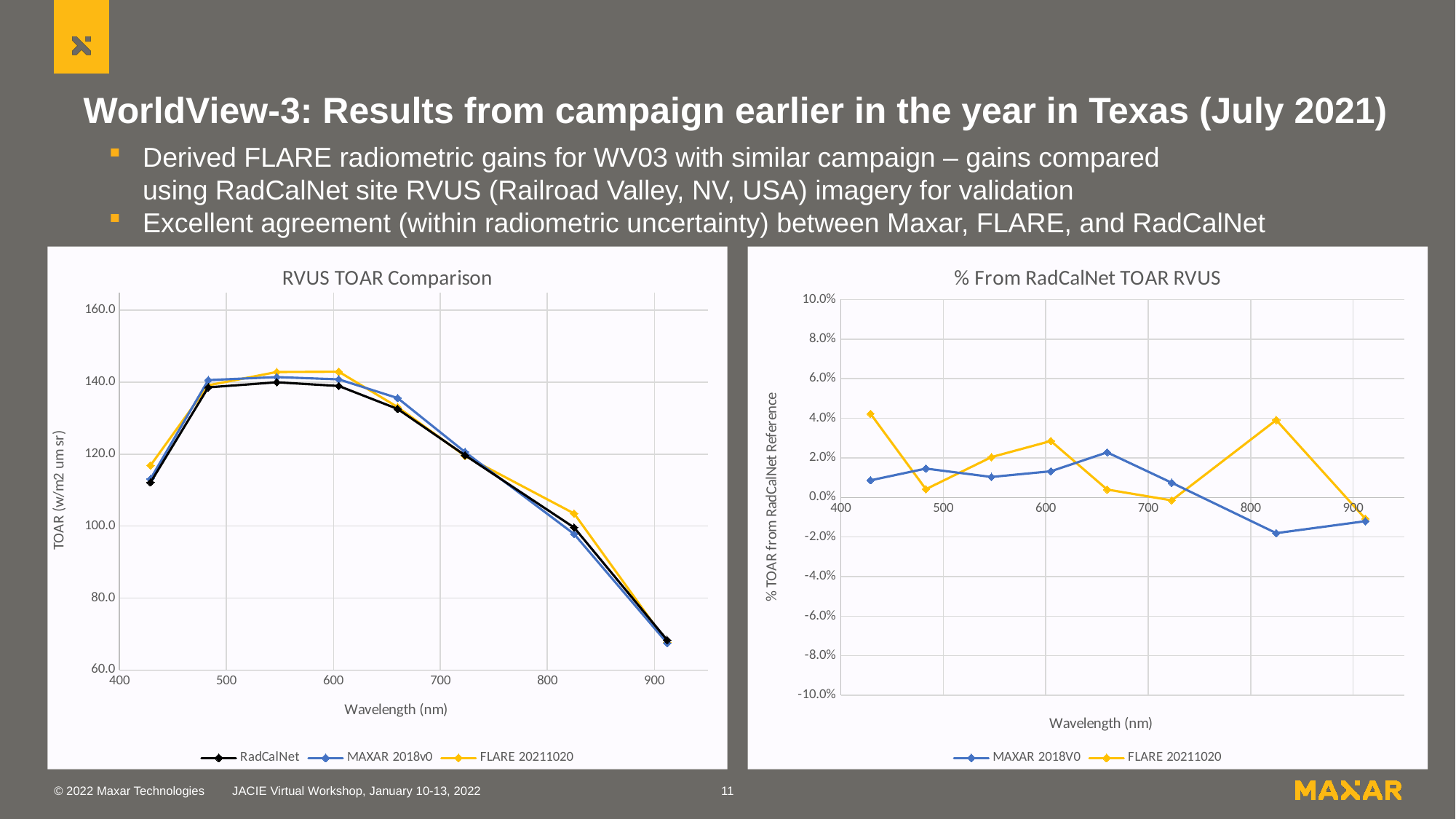
In the left chart "RVUS TOAR Comparison", is the RadCalNet value at the longest wavelength (around 900 nm) greater or less than 80.0? less What kind of chart is the left chart titled "RVUS TOAR Comparison"? line chart In the right chart "% From RadCalNet TOAR RVUS", is the FLARE 20211020 value at the shortest wavelength (around 430 nm) greater or less than 2.0%? greater How many series does the legend of the left chart "RVUS TOAR Comparison" list? 3 In the left chart "RVUS TOAR Comparison", how many data points does the RadCalNet series have? 8 In the right chart "% From RadCalNet TOAR RVUS", is the MAXAR 2018V0 value at around 825 nm greater or less than 0.0%? less In the left chart "RVUS TOAR Comparison", at which wavelength point is the RadCalNet series lowest? the longest wavelength, around 900 nm How many series does the legend of the right chart "% From RadCalNet TOAR RVUS" list? 2 What is the y-axis label of the left chart "RVUS TOAR Comparison"? TOAR (w/m2 um sr) In the left chart "RVUS TOAR Comparison", do the TOAR values rise or fall as wavelength increases from 600 nm to 900 nm? fall In the right chart "% From RadCalNet TOAR RVUS", at the shortest wavelength (around 430 nm), which series has the larger value, MAXAR 2018V0 or FLARE 20211020? FLARE 20211020